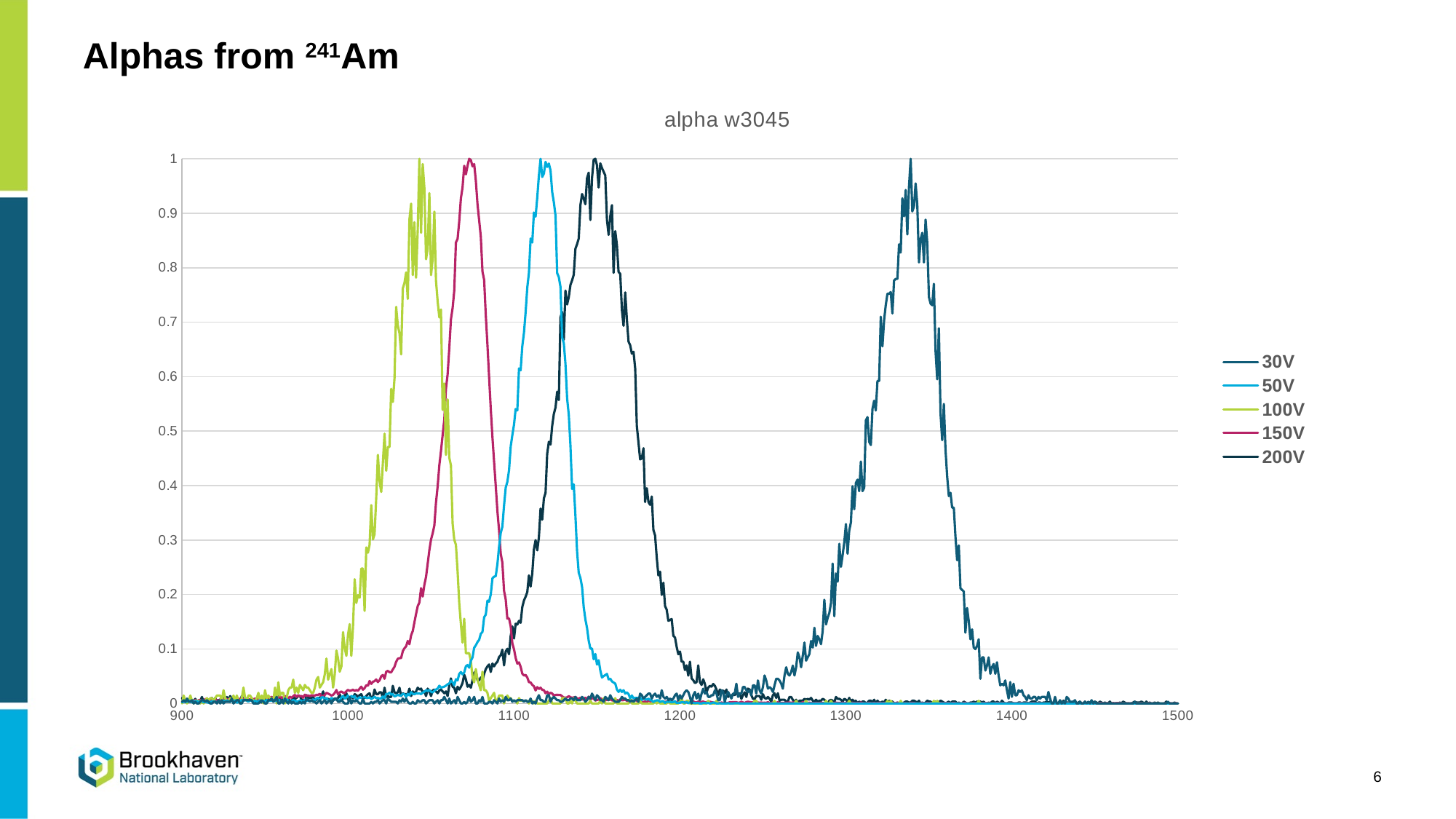
What is the maximum value reached by the 30V series? 1 At x = 1350, which series has the larger value, 30V or 50V? 30V What is the title of the chart? alpha w3045 What kind of chart is shown on the slide? line chart Is the value of the 200V series at x = 1150 greater or less than 0.5? greater Is the value of the 50V series at x = 1100 greater or less than 0.1? greater Which series has its peak furthest to the right along the x axis? 30V Is the value of the 100V series at x = 1050 greater or less than 0.5? greater How many series does the legend list? 5 At x = 1050, which series has the larger value, 100V or 200V? 100V